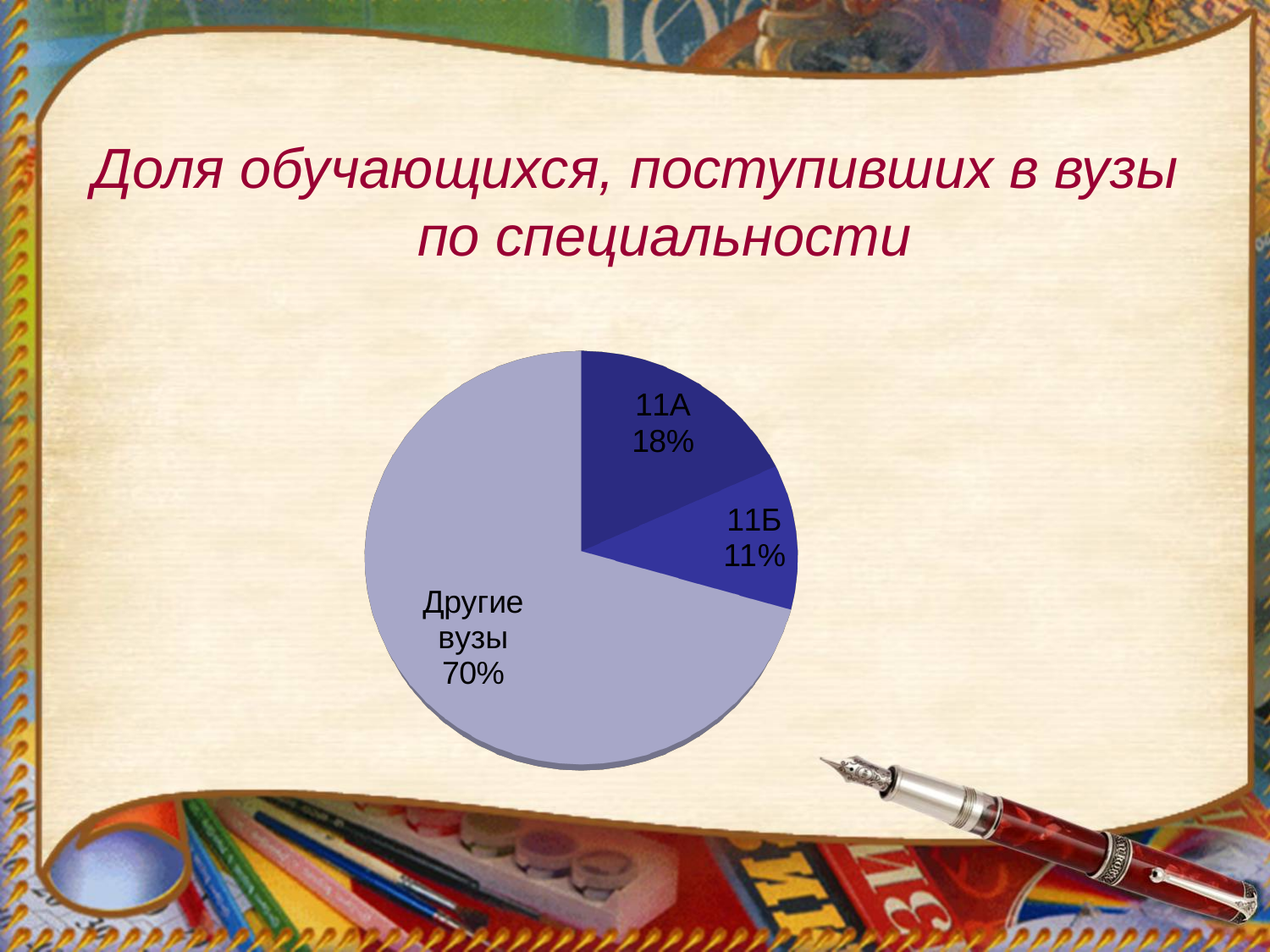
Which slice of the pie is the largest? Другие вузы What is the difference between the shares of 11А and 11Б? 7% What share of the pie does 11А have? 18% Is the share for 11А greater or less than 20%? less How many slices does the pie chart have? 3 Which is larger, the share of 11А or the share of 11Б? 11А What kind of chart is shown on the slide? pie chart What is the title of the slide above the chart? Доля обучающихся, поступивших в вузы по специальности What is the difference between the shares of Другие вузы and 11А? 52% Which slice of the pie is the smallest? 11Б What share of the pie does Другие вузы have? 70% What share of the pie does 11Б have? 11%